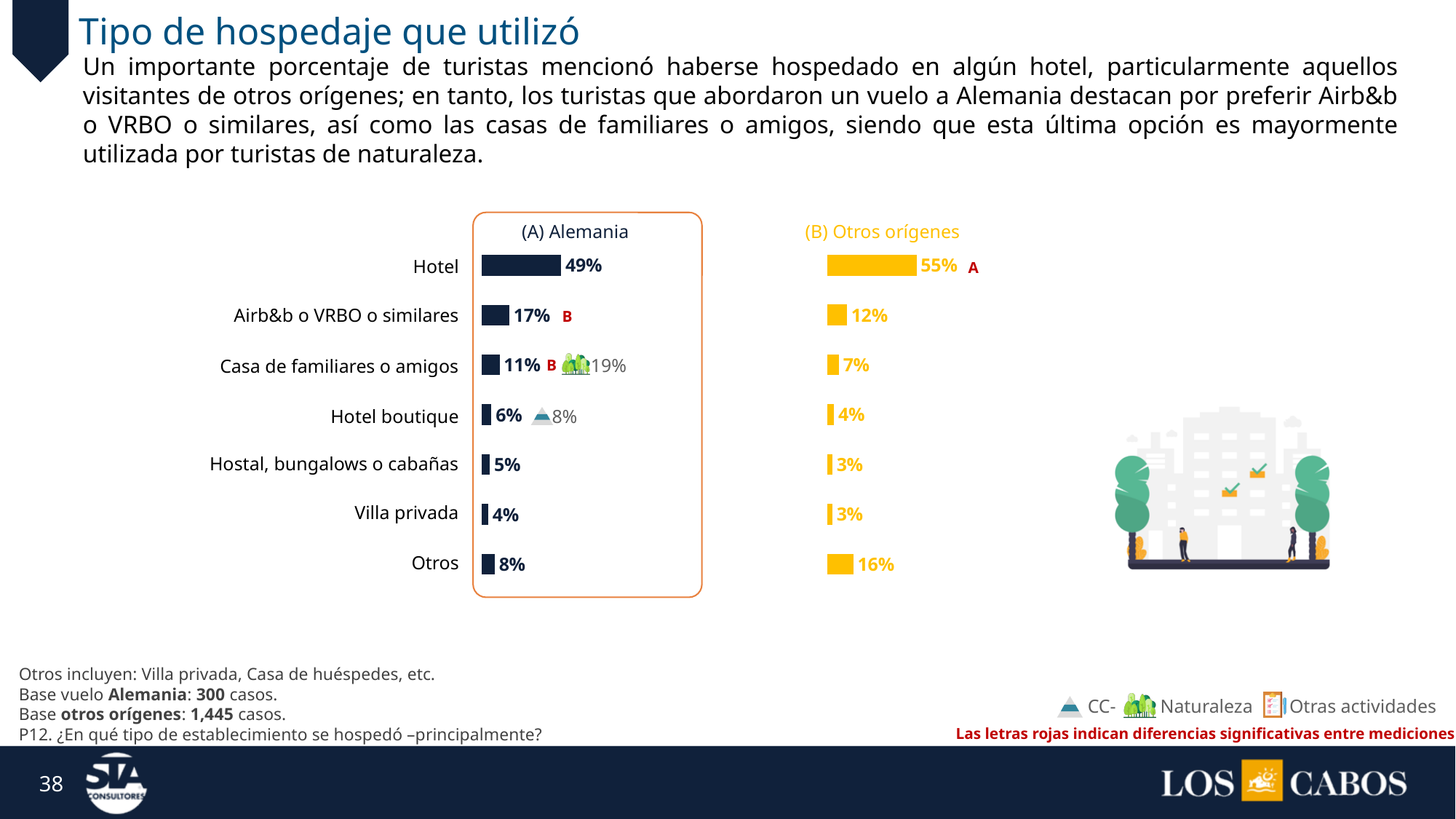
In the (A) Alemania chart, what is the value for Airb&b o VRBO o similares? 17% How many accommodation categories are shown in the (A) Alemania chart? 7 What is the difference between the Hotel value in the (B) Otros orígenes chart and the Hotel value in the (A) Alemania chart? 6% What colour are the bars in the (B) Otros orígenes chart? Yellow In the (A) Alemania chart, what is the difference between Airb&b o VRBO o similares and Casa de familiares o amigos? 6% In the (B) Otros orígenes chart, what is the value for Casa de familiares o amigos? 7% What type of chart is used for (A) Alemania and (B) Otros orígenes? Bar chart In the (A) Alemania chart, what is the value for Hotel? 49% Which is larger: the Otros value in the (A) Alemania chart or the Otros value in the (B) Otros orígenes chart? (B) Otros orígenes In the (B) Otros orígenes chart, what is the value for Otros? 16% In the (B) Otros orígenes chart, which category has the highest value? Hotel In the (A) Alemania chart, which category has the lowest value? Villa privada